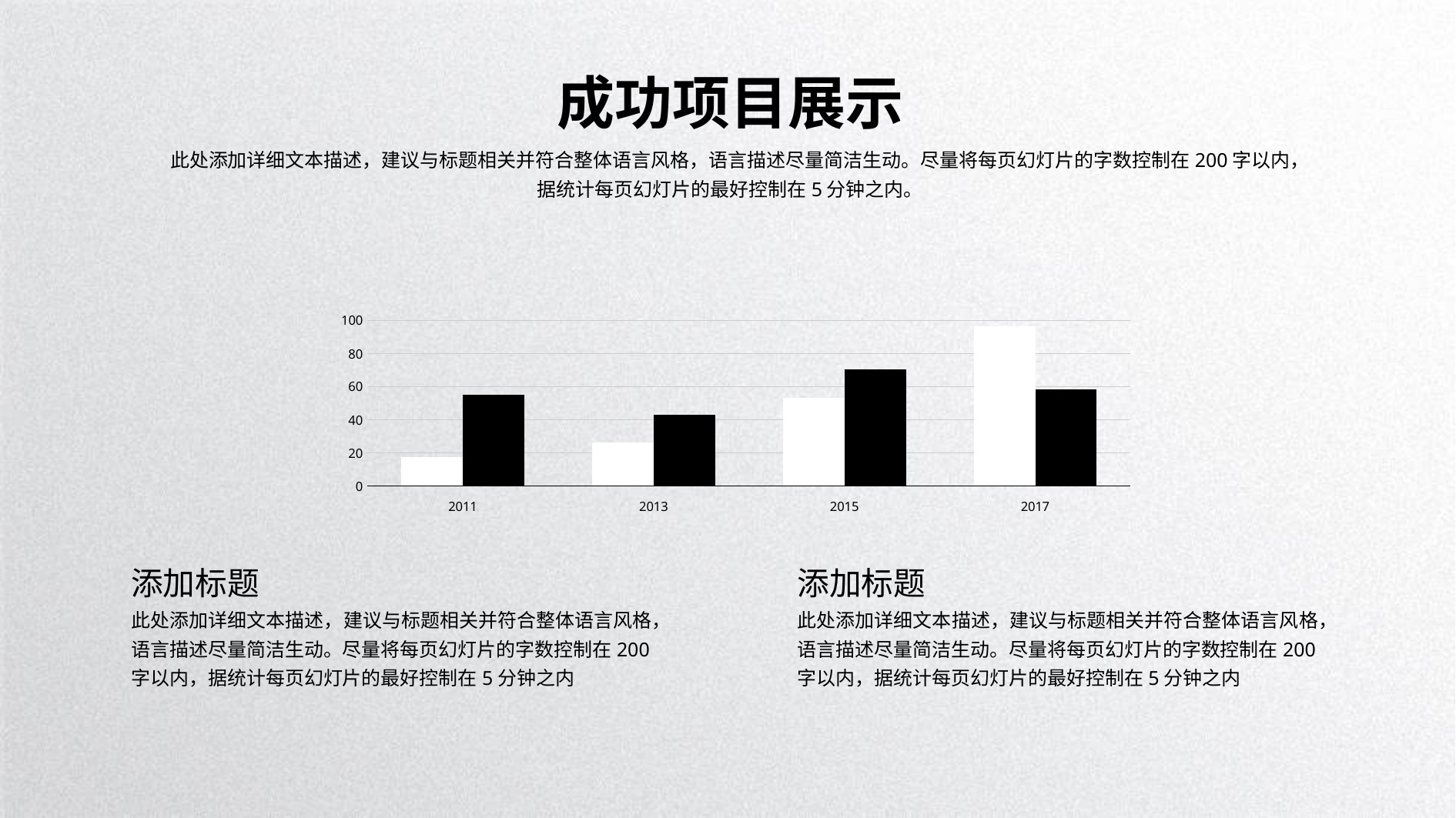
For 2011, which bar is taller, the white bar or the black bar? the black bar Do the white bars rise or fall from 2011 to 2017? rise How many bars are plotted for each year in the chart? 2 In which year is the white bar the shortest? 2011 In which year is the black bar the shortest? 2013 Is the value of the white bar for 2017 greater or less than 80? greater In which year is the white bar the tallest? 2017 How many categories (years) are shown on the x axis of the chart? 4 In which year is the black bar the tallest? 2015 What kind of chart is shown on the slide? bar chart For 2017, which bar is taller, the white bar or the black bar? the white bar